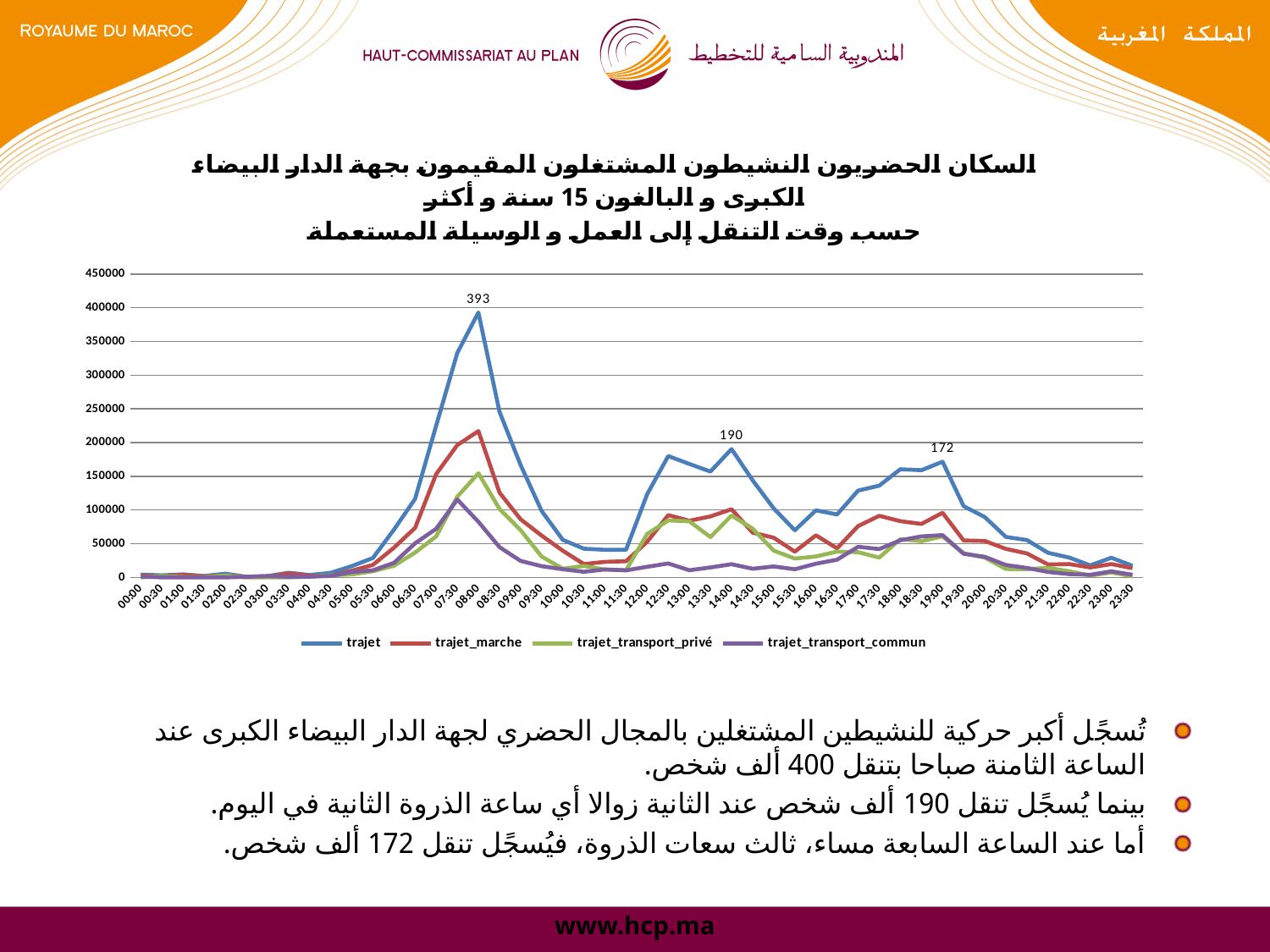
What value is labelled on the trajet line at 14:00? 190 What value is labelled on the trajet line at 08:00? 393 What colour is the trajet line in the chart? blue At which time does the trajet line reach its highest value? 08:00 What is the difference between the labelled values at 14:00 (190) and 19:00 (172)? 18 What value is labelled on the trajet line at 19:00? 172 Is the value of trajet_transport_commun at 08:00 greater or less than 150000? less Which is larger, the trajet value at 14:00 or at 19:00? 14:00 How many series does the legend list? 4 What kind of chart is shown on the slide? line chart Does the trajet line rise or fall between 08:00 and 10:30? fall What is the difference between the labelled values at 08:00 (393) and 14:00 (190)? 203